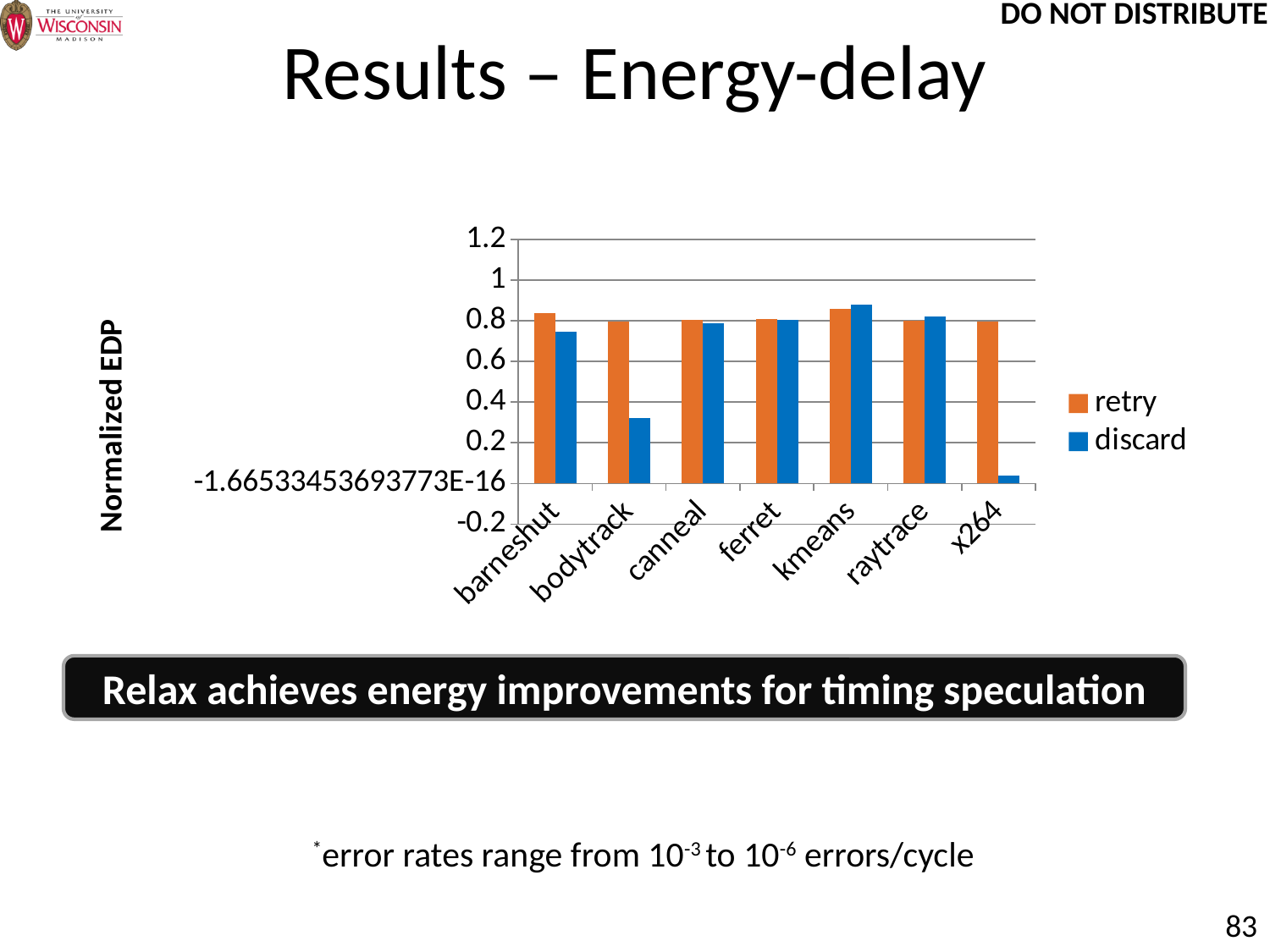
For bodytrack, which is larger: the retry value or the discard value? retry What kind of chart is shown on the slide? bar chart Is the discard value for bodytrack greater or less than 0.4? less What is the label on the y axis? Normalized EDP Which category has the highest discard value? kmeans Is the retry value for barneshut greater or less than 0.8? greater Which category has the lowest discard value? x264 Is the discard value for x264 greater or less than 0.2? less How many benchmark categories are shown on the x axis? 7 Which colour represents the discard series in the legend? blue For kmeans, which is larger: the retry value or the discard value? discard How many series does the legend list? 2